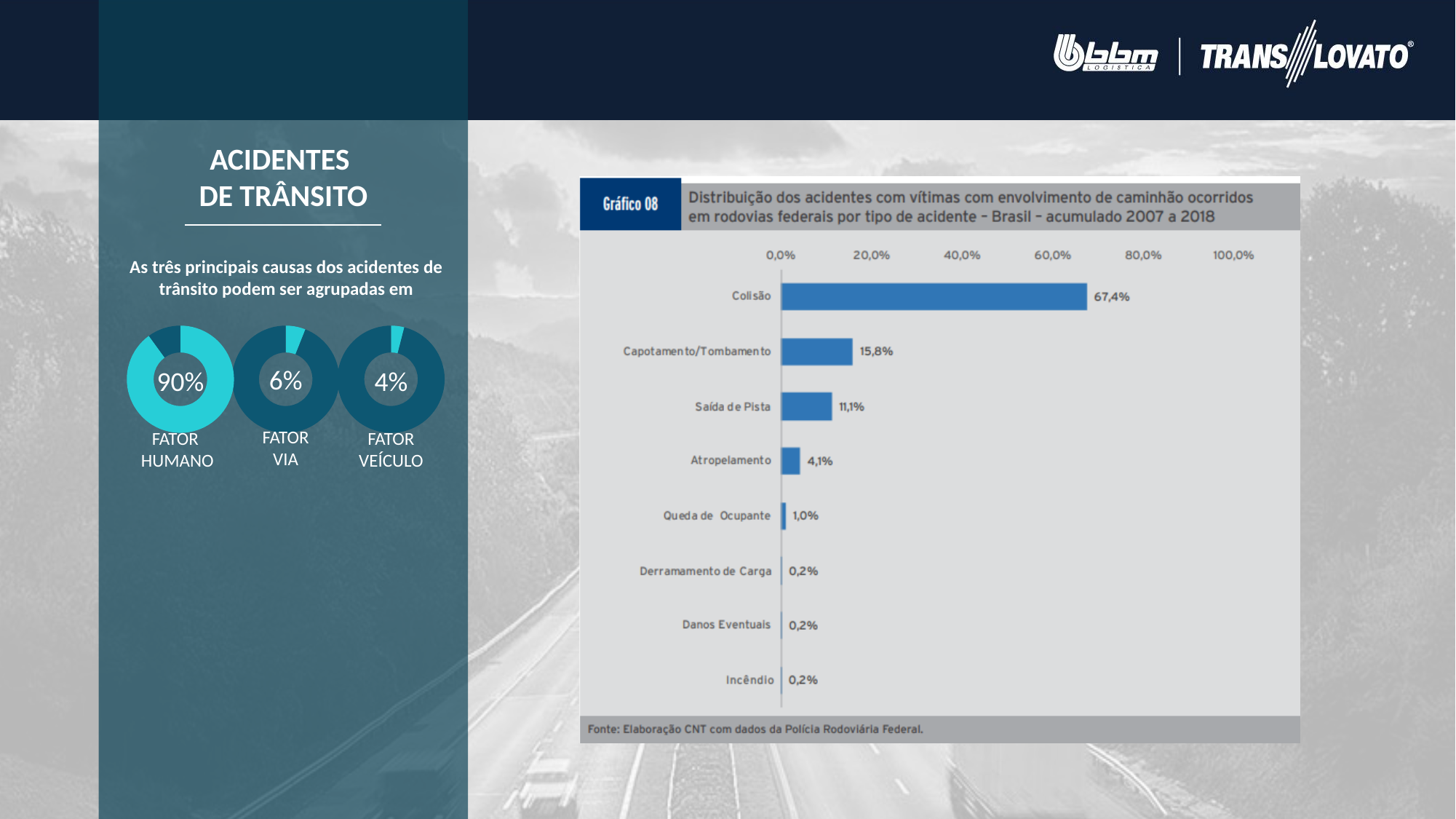
What kind of chart is Gráfico 08? bar chart In the donut charts on the left, which factor has the lowest share? Fator Veículo In the Gráfico 08 bar chart, which is larger, Capotamento/Tombamento or Atropelamento? Capotamento/Tombamento In the Gráfico 08 bar chart, is the value for Colisão greater or less than 60,0%? greater In the Gráfico 08 bar chart, what is the value for Saída de Pista? 11,1% In the Gráfico 08 bar chart, which type of accident has the highest share? Colisão In the donut charts on the left, what is the value for Fator Humano? 90% How many accident types are shown in the Gráfico 08 bar chart? 8 In the Gráfico 08 bar chart, what is the difference between Colisão and Capotamento/Tombamento? 51,6% In the Gráfico 08 bar chart, what is the value for Queda de Ocupante? 1,0% In the Gráfico 08 bar chart, what is the value for Colisão? 67,4% In the donut charts on the left, what is the difference between Fator Via and Fator Veículo? 2%